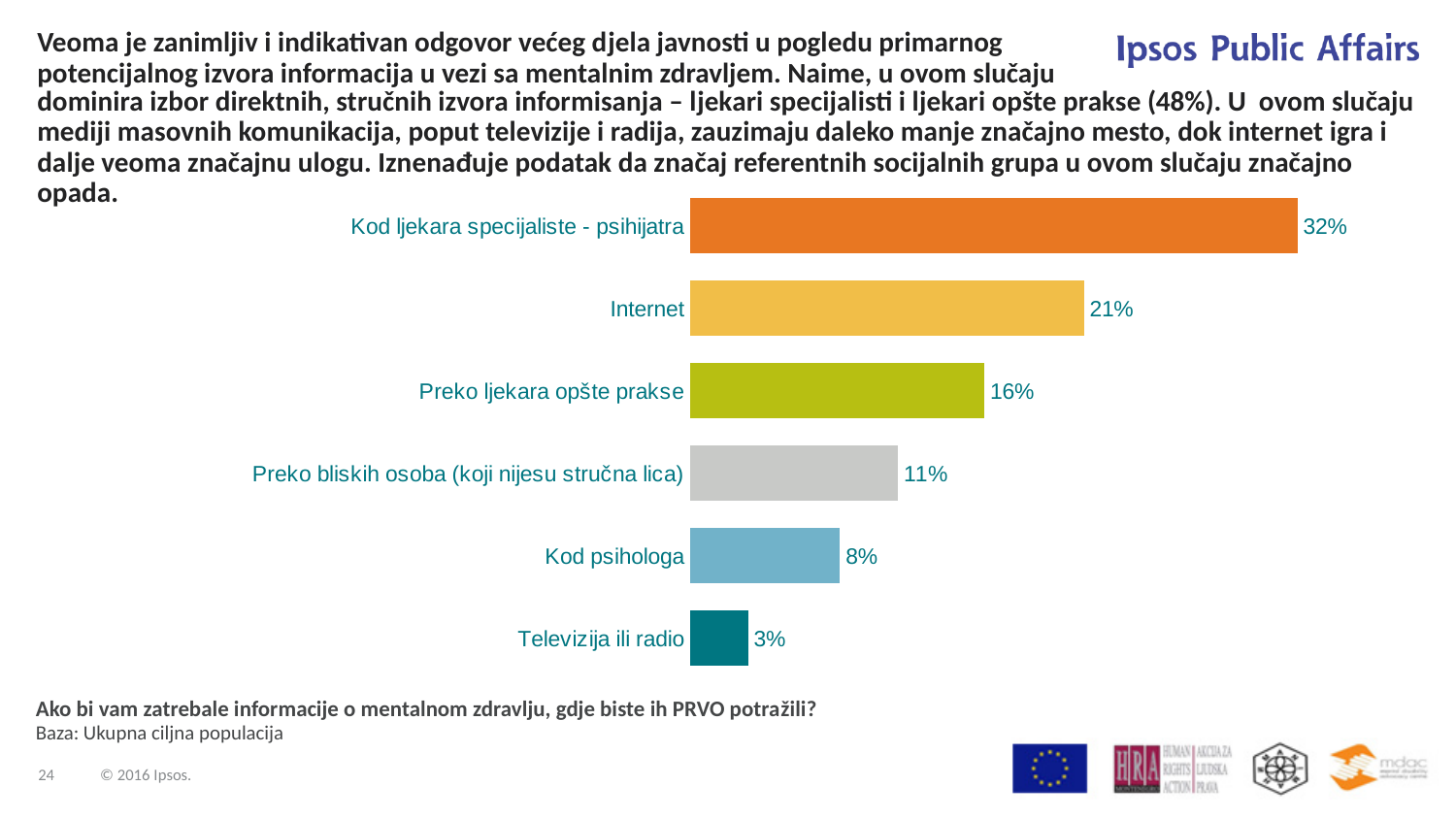
What is the value for "Preko bliskih osoba (koji nijesu stručna lica)"? 11% What is the difference between the values for "Preko ljekara opšte prakse" and "Televizija ili radio"? 13% What is the value for "Kod psihologa"? 8% Which is larger, the value for "Internet" or the value for "Preko ljekara opšte prakse"? Internet Which category has the highest value? Kod ljekara specijaliste - psihijatra What is the combined value of "Kod ljekara specijaliste - psihijatra" and "Preko ljekara opšte prakse"? 48% How many categories are shown in the chart? 6 Which category has the lowest value? Televizija ili radio What is the value for "Internet"? 21% What colour is the bar for "Kod ljekara specijaliste - psihijatra"? Orange What is the difference between the values for "Kod ljekara specijaliste - psihijatra" and "Internet"? 11% What kind of chart is shown on the slide? Bar chart